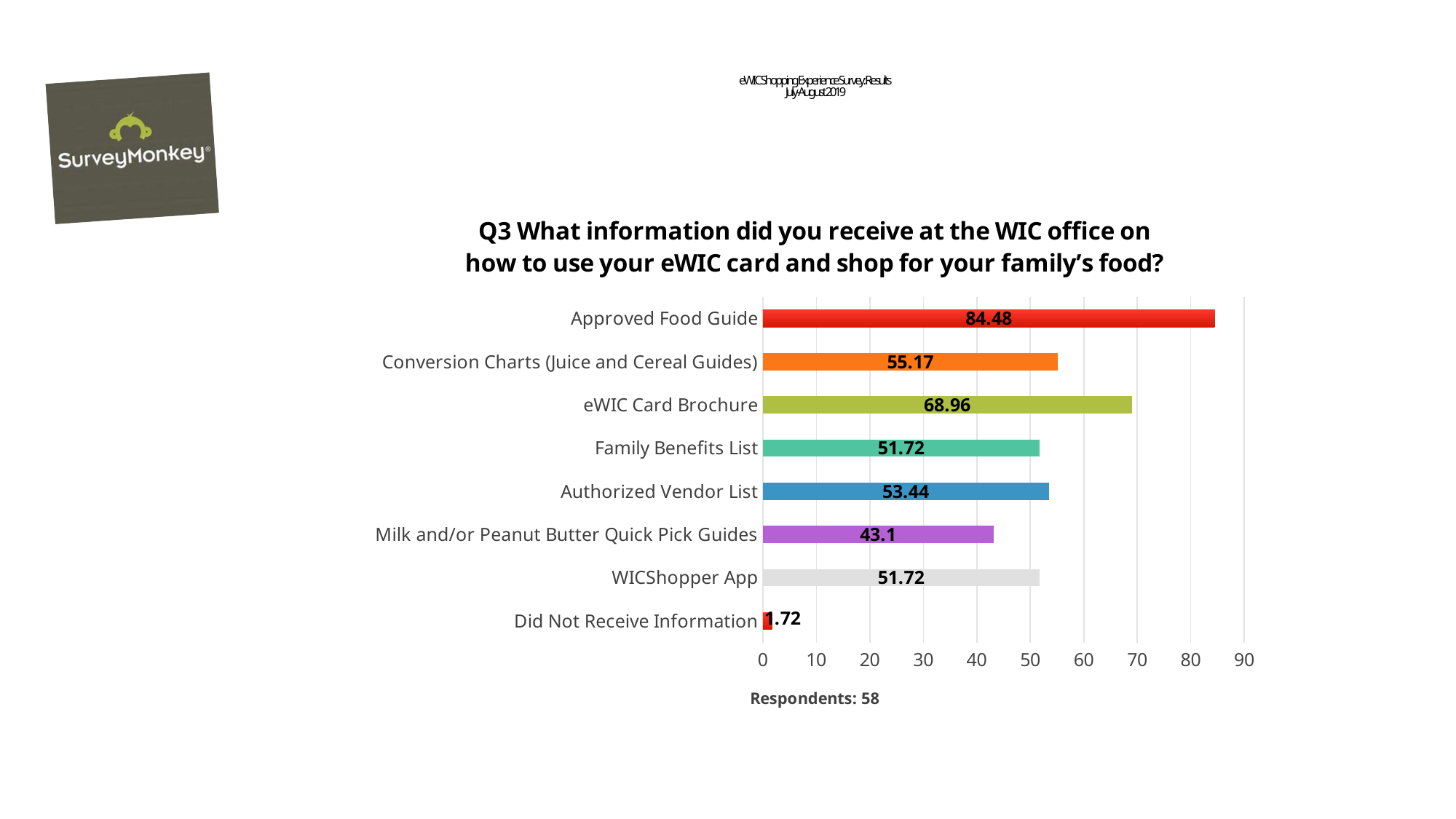
Which category has the highest value? Approved Food Guide What is the value for Approved Food Guide? 84.48 How many categories are shown in the chart? 8 What is the value for eWIC Card Brochure? 68.96 Is the value for Family Benefits List greater or less than 50? greater Which category has the lowest value? Did Not Receive Information Which is larger, the value for Conversion Charts (Juice and Cereal Guides) or the value for Authorized Vendor List? Conversion Charts (Juice and Cereal Guides) How many respondents does the slide report for this question? 58 What is the difference between the values for Approved Food Guide and eWIC Card Brochure? 15.52 What is the value for Milk and/or Peanut Butter Quick Pick Guides? 43.1 What is the value for Did Not Receive Information? 1.72 What kind of chart is shown on the slide? bar chart